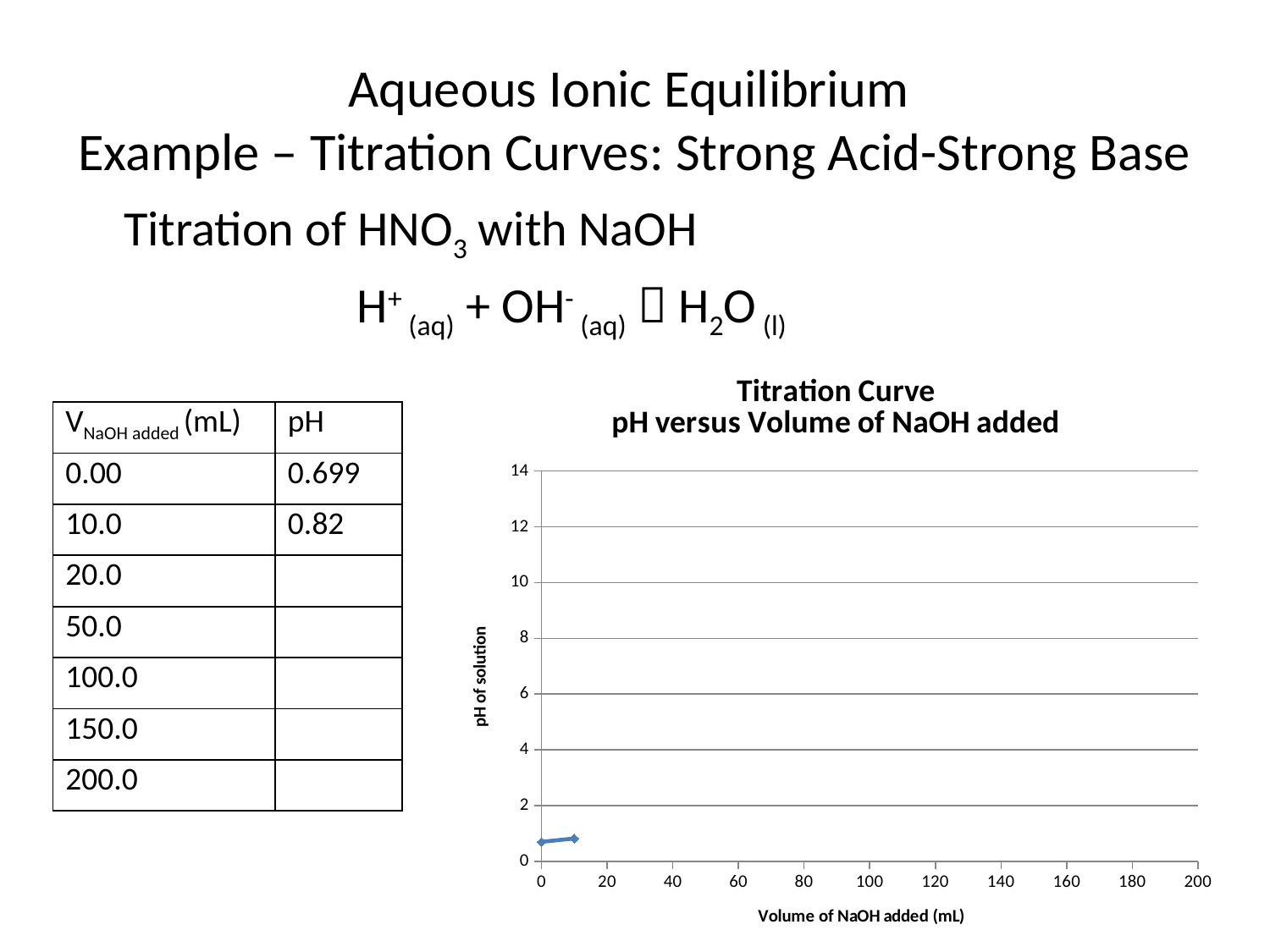
Is the pH value plotted at 0 mL of NaOH added greater or less than 2? less Does the plotted pH rise or fall as the volume of NaOH added increases from 0 to 10 mL? rise What is the title of the chart? Titration Curve pH versus Volume of NaOH added What kind of chart is shown on the slide? line chart What is the label on the x axis of the chart? Volume of NaOH added (mL) How many data points are plotted on the titration curve? 2 Is the pH value plotted at 10 mL of NaOH added greater or less than 4? less Is the pH value plotted at 10 mL of NaOH added greater or less than 2? less